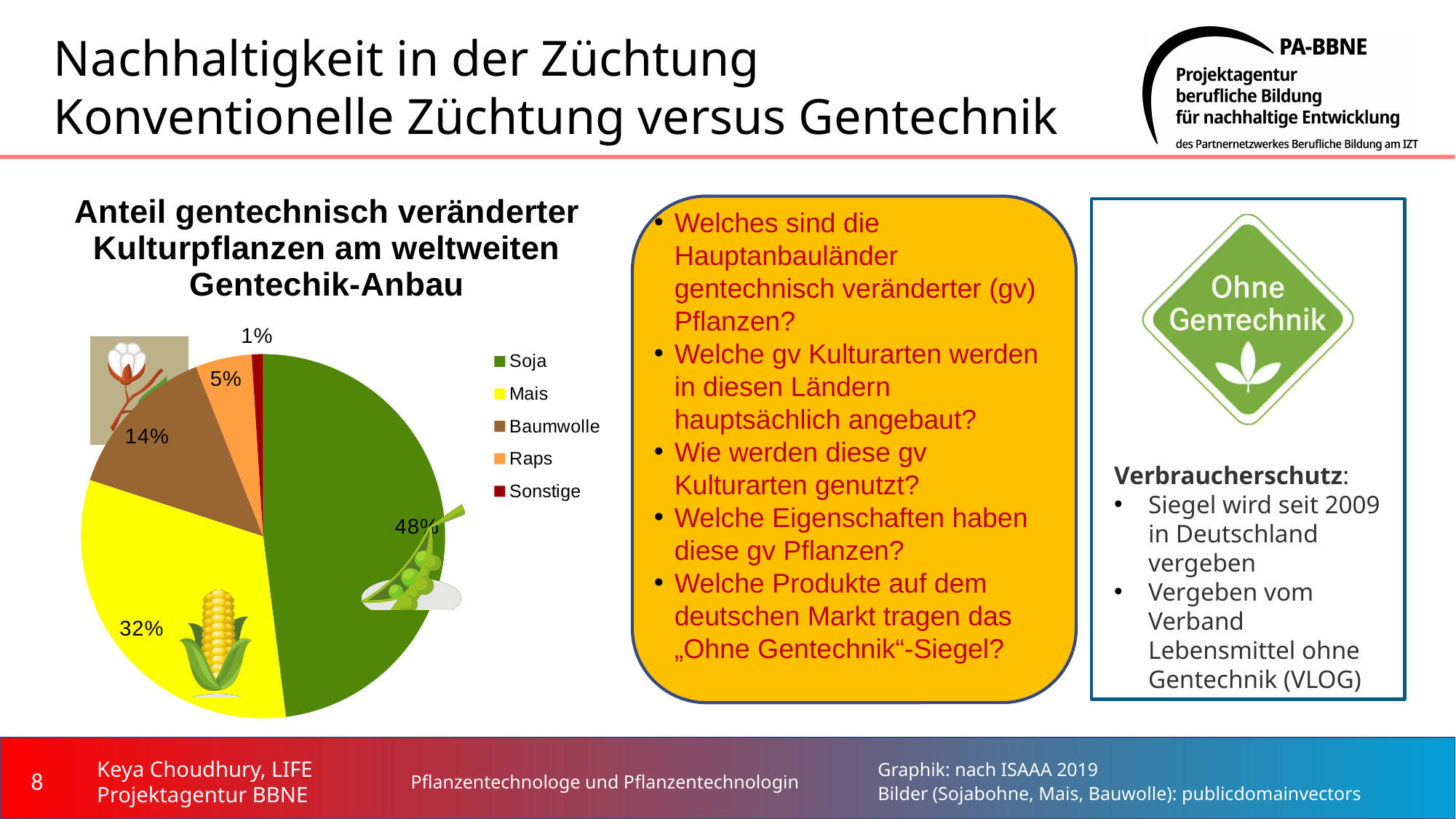
What share of the pie does Soja have? 48% Which category has the smallest share of the pie? Sonstige What is the title of the pie chart? Anteil gentechnisch veränderter Kulturpflanzen am weltweiten Gentechik-Anbau Which category has the largest share of the pie? Soja What is the value shown for Raps? 5% Which is larger, the share for Baumwolle or the share for Raps? Baumwolle How many categories does the legend of the pie chart list? 5 What share of the pie does Mais have? 32% What is the difference in percentage points between Soja and Mais? 16 What is the value shown for Sonstige? 1% What is the value shown for Baumwolle? 14% What type of chart is shown on the slide? pie chart